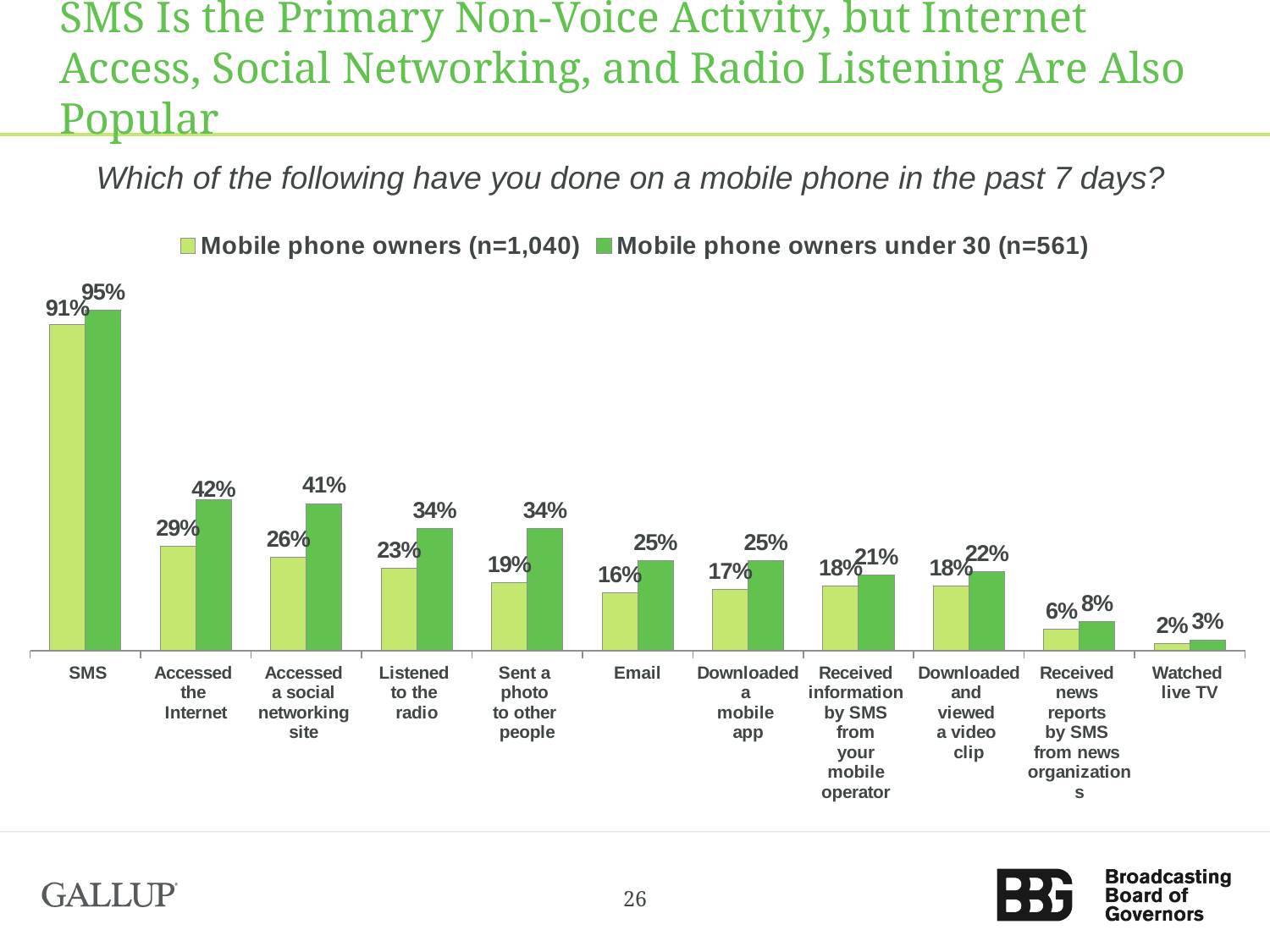
What percentage of mobile phone owners (n=1,040) sent SMS in the past 7 days? 91% Which activity has the highest value for mobile phone owners (n=1,040)? SMS Which is larger for mobile phone owners (n=1,040): Accessed the Internet or Accessed a social networking site? Accessed the Internet What is the value for Email among mobile phone owners under 30? 25% What kind of chart is shown on the slide? Bar chart Which activity has the lowest value for mobile phone owners under 30? Watched live TV How many activity categories are shown on the x axis? 11 How many series does the legend list? 2 What percentage of mobile phone owners under 30 (n=561) accessed the Internet on a mobile phone? 42% What is the difference between mobile phone owners under 30 and all mobile phone owners for Listened to the radio? 11% What is the value for Received news reports by SMS from news organizations among mobile phone owners (n=1,040)? 6% What survey question is shown above the chart? Which of the following have you done on a mobile phone in the past 7 days?